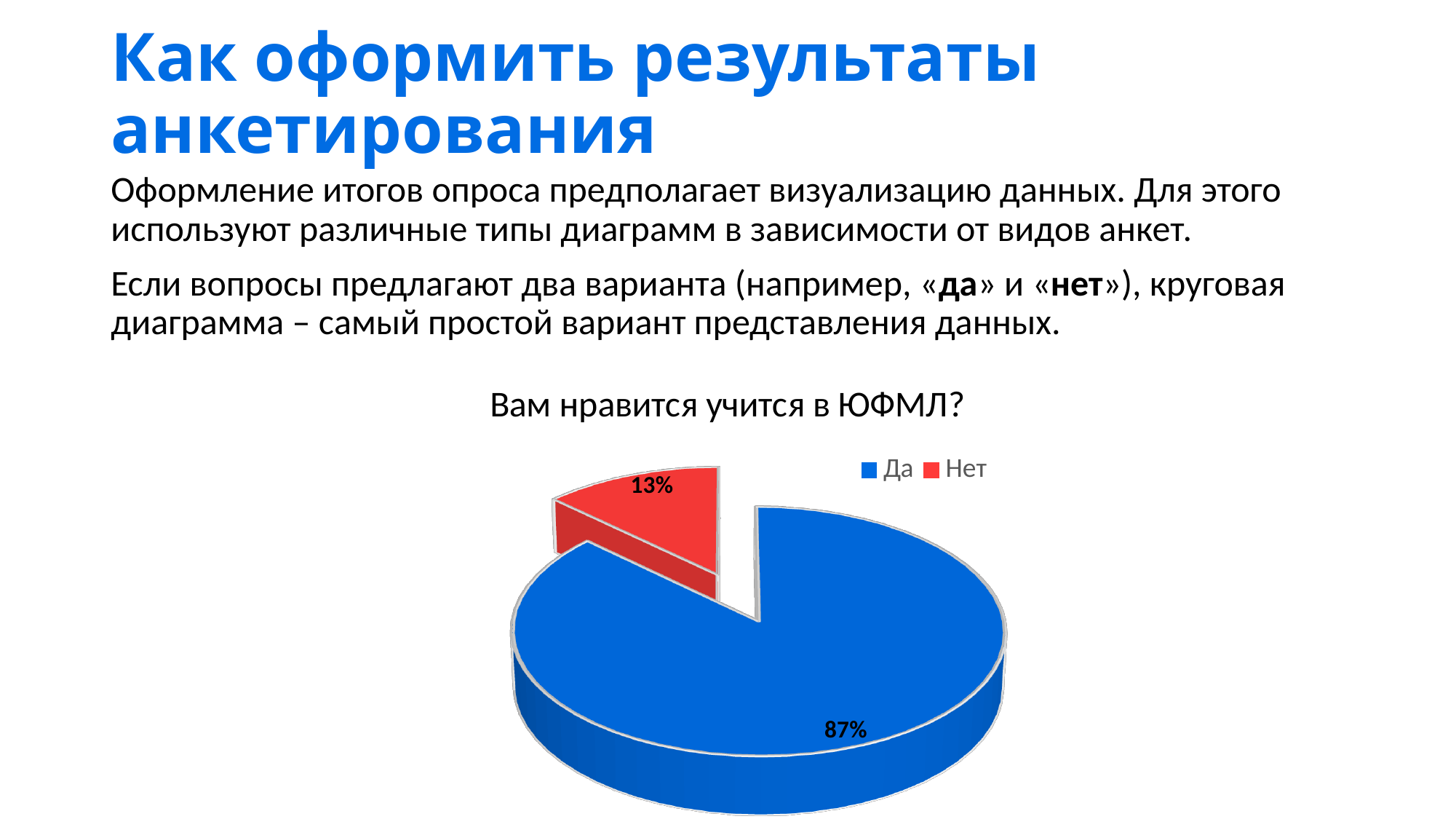
What is the title of the chart? Вам нравится учится в ЮФМЛ? How many slices does the pie chart have? 2 What colour is the "Нет" slice? red Which is larger, the "Да" slice or the "Нет" slice? Да What is the difference in percentage points between the "Да" and "Нет" slices? 74 Which slice is the largest in the pie chart? Да How many entries does the legend list? 2 What kind of chart is shown on the slide? pie chart Which slice is the smallest in the pie chart? Нет What share of the pie does the "Нет" slice represent? 13% What share of the pie does the "Да" slice represent? 87%